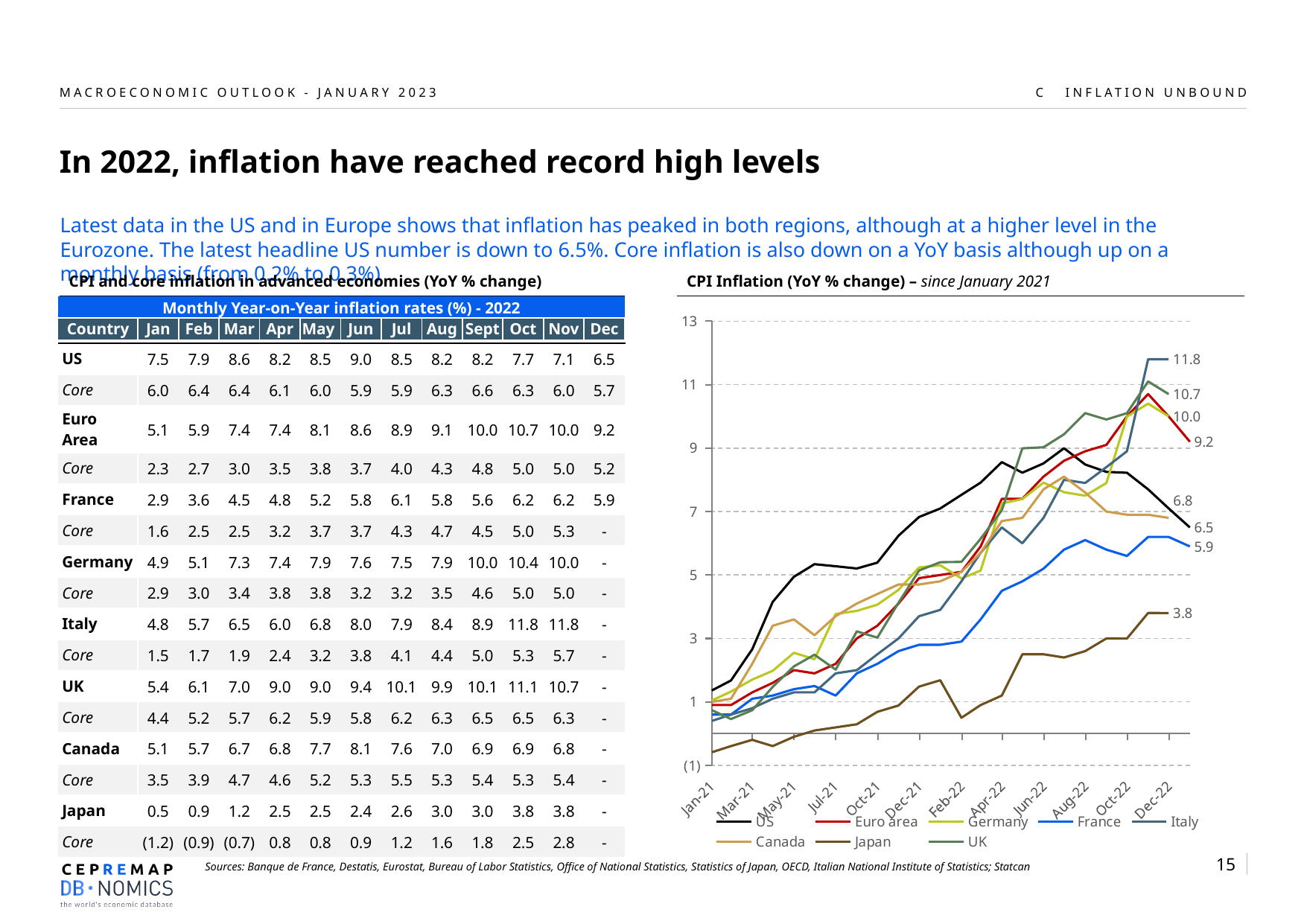
In the CPI Inflation chart, what is the difference between the latest labelled values for Italy and the US? 5.3 In the CPI Inflation chart, what is the latest labelled value for Italy? 11.8 In the CPI Inflation chart, which country has the highest latest labelled value? Italy How many series does the legend of the CPI Inflation chart list? 8 In the CPI Inflation chart, is the US value in Jan-21 greater or less than 3? less In the CPI Inflation chart, what is the latest labelled value for France? 5.9 In the CPI Inflation chart, what is the latest labelled value for Japan? 3.8 What kind of chart is shown on the right side of the slide? line chart In the CPI Inflation chart, does the Japan line rise or fall overall from Jan-21 to the end of the series? rise In the CPI Inflation chart, what is the latest labelled value for the US? 6.5 In the CPI Inflation chart, which has the larger latest labelled value, the Euro area or Canada? Euro area In the CPI Inflation chart, which country has the lowest latest labelled value? Japan